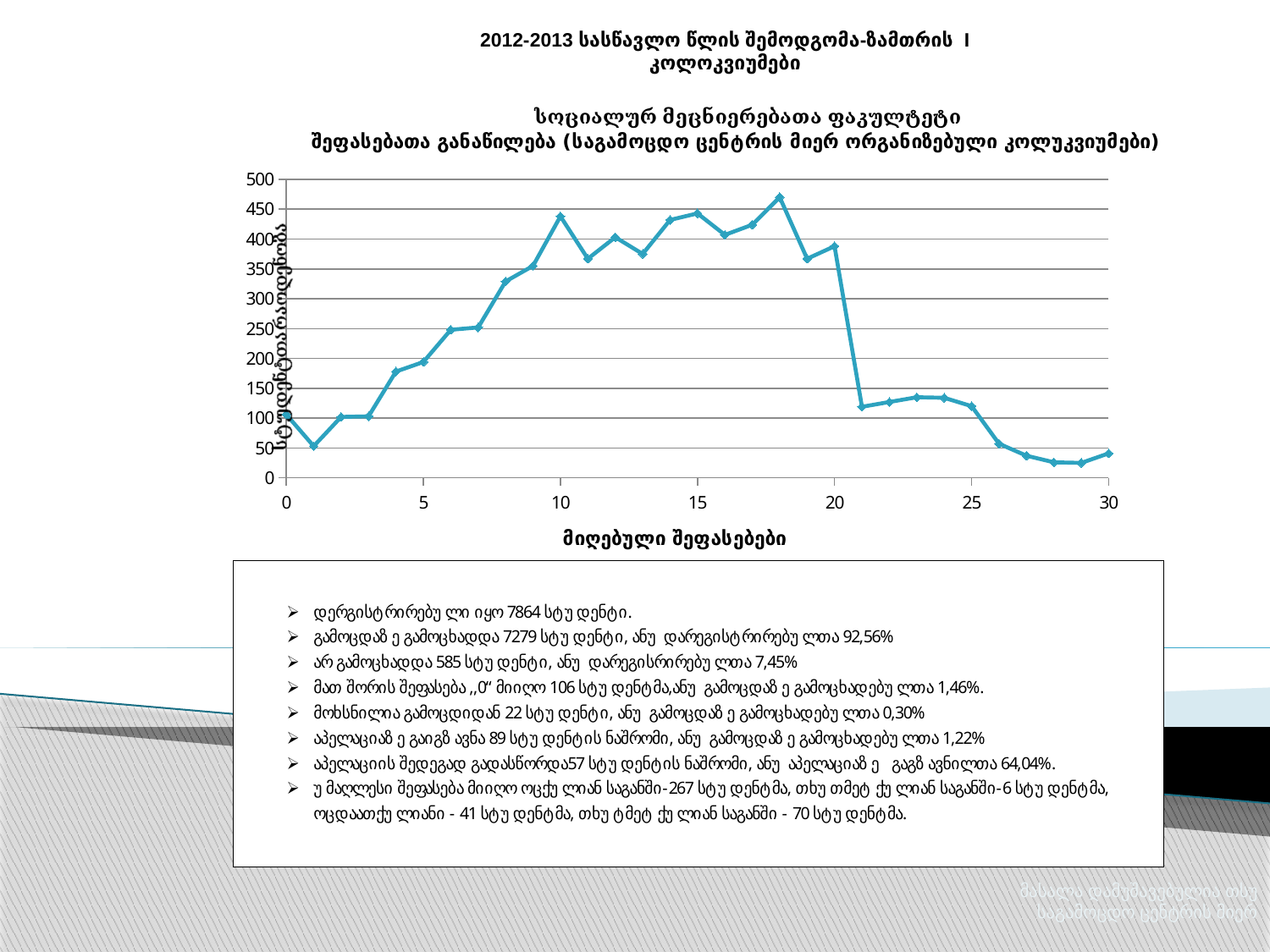
Do the values generally rise or fall between x = 0 and x = 10? rise Which is larger, the value at x = 20 or the value at x = 21? x = 20 At which x-axis value does the line reach its highest point? 18 Is the value at x = 21 greater or less than 150? less Is the value at x = 8 greater or less than 300? greater What kind of chart is shown on the slide? line chart Is the value at x = 5 greater or less than 250? less What is the title of the x axis of the chart? მიღებული შეფასებები Which is larger, the value at x = 10 or the value at x = 11? x = 10